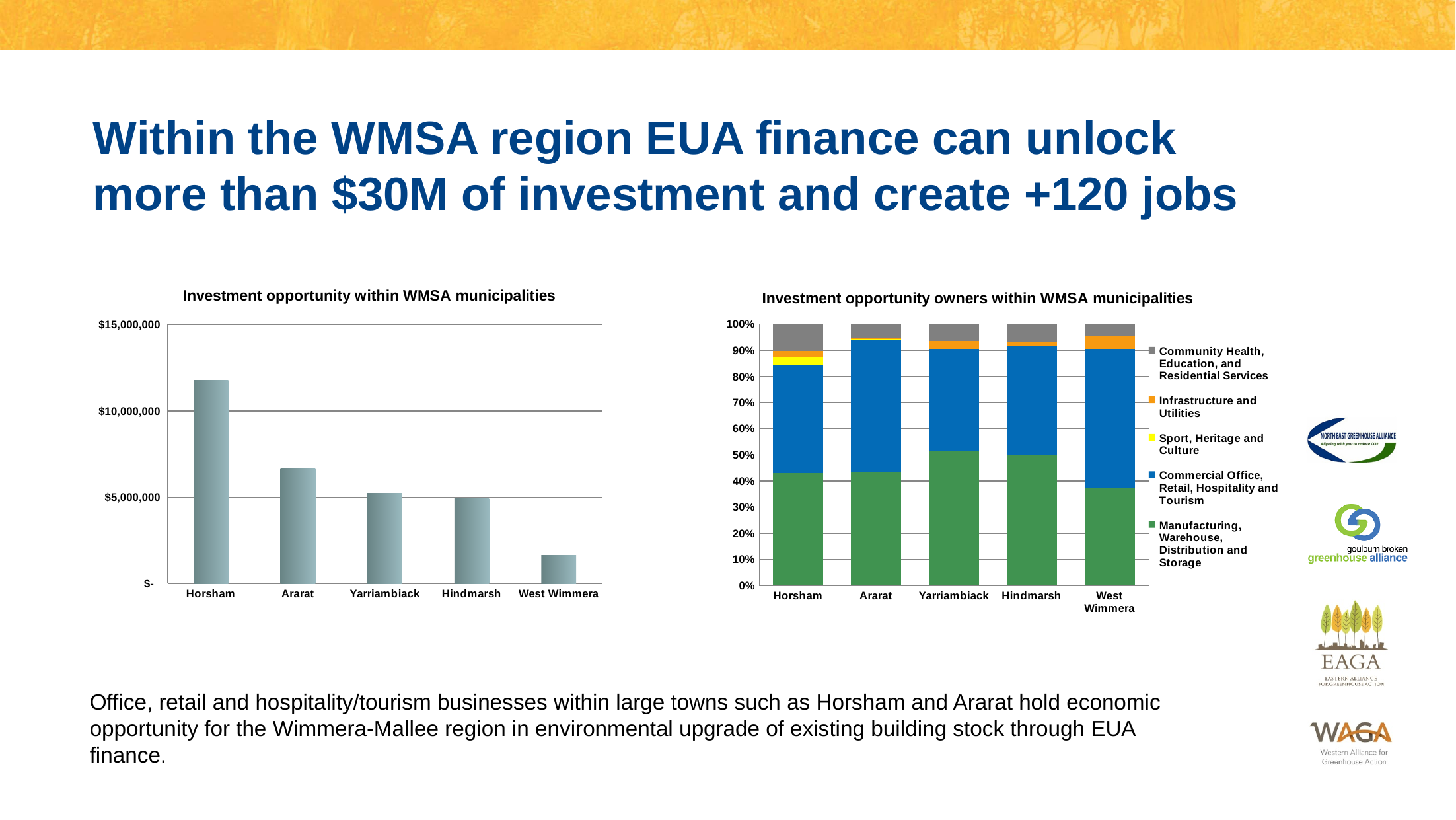
On the chart titled 'Investment opportunity owners within WMSA municipalities', which series is shown in yellow? Sport, Heritage and Culture On the chart titled 'Investment opportunity within WMSA municipalities', which municipality has the highest investment opportunity? Horsham What kind of chart is the chart titled 'Investment opportunity within WMSA municipalities'? Bar chart On the chart titled 'Investment opportunity within WMSA municipalities', which is larger, the value for Horsham or the value for Ararat? Horsham On the chart titled 'Investment opportunity owners within WMSA municipalities', which municipality has the smallest share for Manufacturing, Warehouse, Distribution and Storage? West Wimmera On the chart titled 'Investment opportunity within WMSA municipalities', is the value for West Wimmera greater or less than $5,000,000? less On the chart titled 'Investment opportunity within WMSA municipalities', is the value for Horsham greater or less than $10,000,000? greater On the chart titled 'Investment opportunity owners within WMSA municipalities', is the Manufacturing, Warehouse, Distribution and Storage share for West Wimmera greater or less than 40%? less On the chart titled 'Investment opportunity owners within WMSA municipalities', how many series does the legend list? 5 On the chart titled 'Investment opportunity within WMSA municipalities', which municipality has the lowest investment opportunity? West Wimmera On the chart titled 'Investment opportunity within WMSA municipalities', how many municipalities are shown? 5